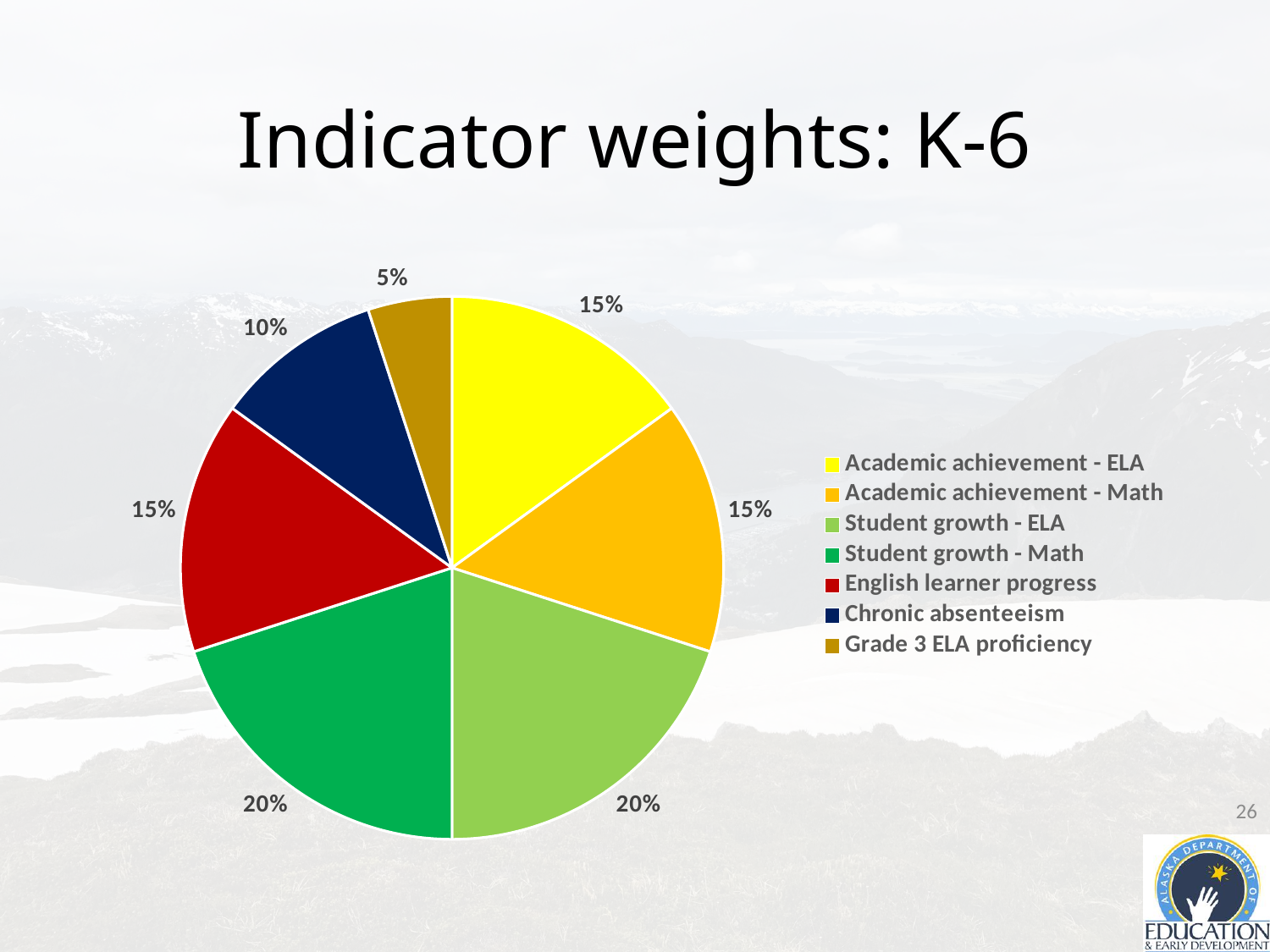
What is the title of the slide containing the pie chart? Indicator weights: K-6 What is the difference between the weights for Student growth - ELA and Chronic absenteeism? 10% Which indicator has the smallest weight? Grade 3 ELA proficiency Which has a larger weight, Academic achievement - Math or Grade 3 ELA proficiency? Academic achievement - Math What is the weight for English learner progress? 15% What is the combined weight of Student growth - ELA and Student growth - Math? 40% What is the weight for Grade 3 ELA proficiency? 5% What is the weight for Chronic absenteeism? 10% What is the weight for Student growth - Math? 20% How many indicators are shown in the pie chart? 7 What kind of chart is shown on the slide? Pie chart What is the weight for Academic achievement - ELA? 15%